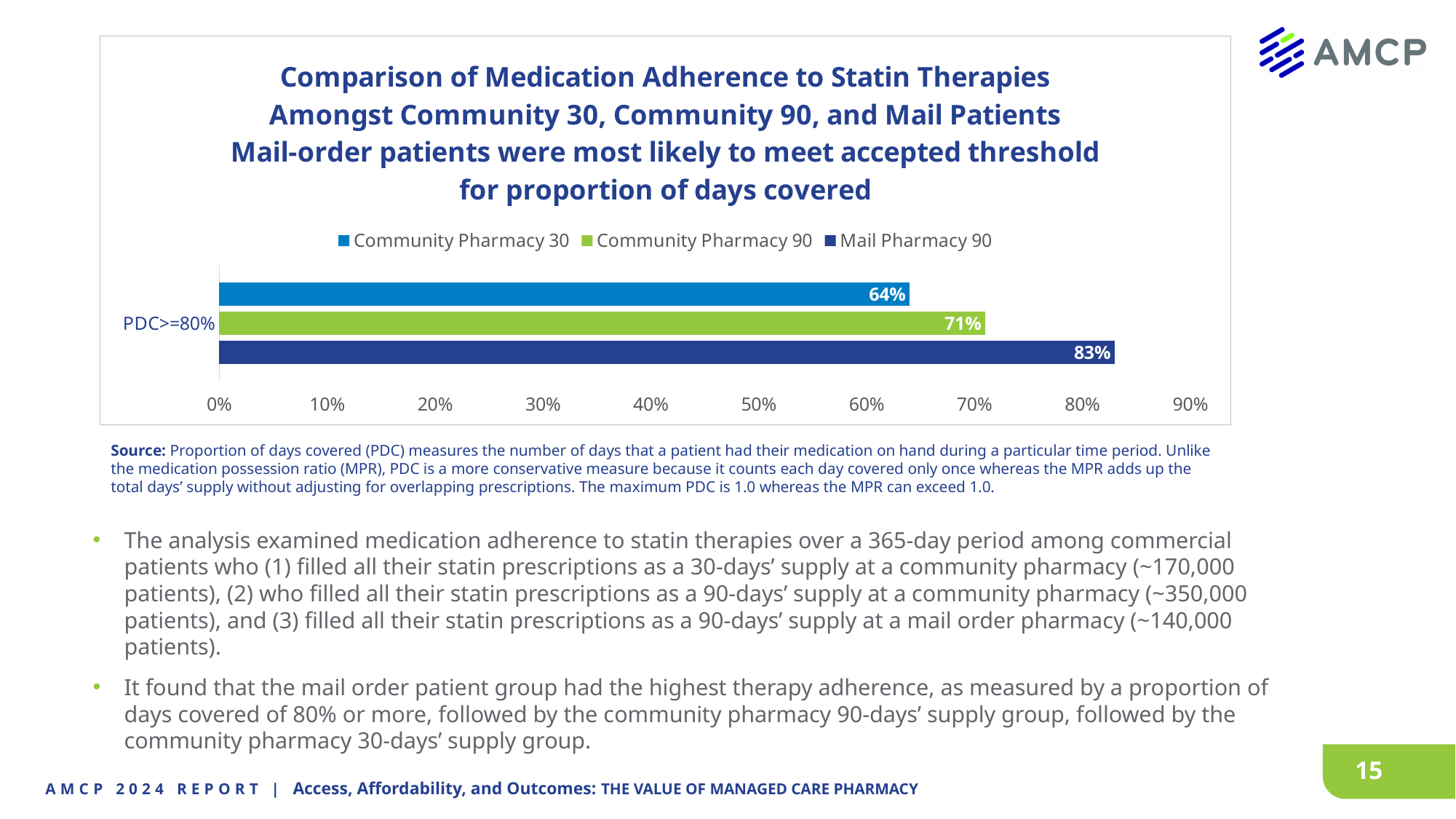
What is the value for Community Pharmacy 90? 71% Is the value for Mail Pharmacy 90 greater or less than 80%? greater What is the value for Mail Pharmacy 90? 83% What is the category label on the vertical axis? PDC>=80% What is the value for Community Pharmacy 30? 64% What kind of chart is shown? Bar chart What is the difference between the Mail Pharmacy 90 value and the Community Pharmacy 30 value? 19% What is the difference between the Community Pharmacy 90 value and the Community Pharmacy 30 value? 7% Which series has the lowest value? Community Pharmacy 30 Which is larger, the value for Community Pharmacy 90 or the value for Mail Pharmacy 90? Mail Pharmacy 90 How many series does the legend list? 3 Which series has the highest value? Mail Pharmacy 90